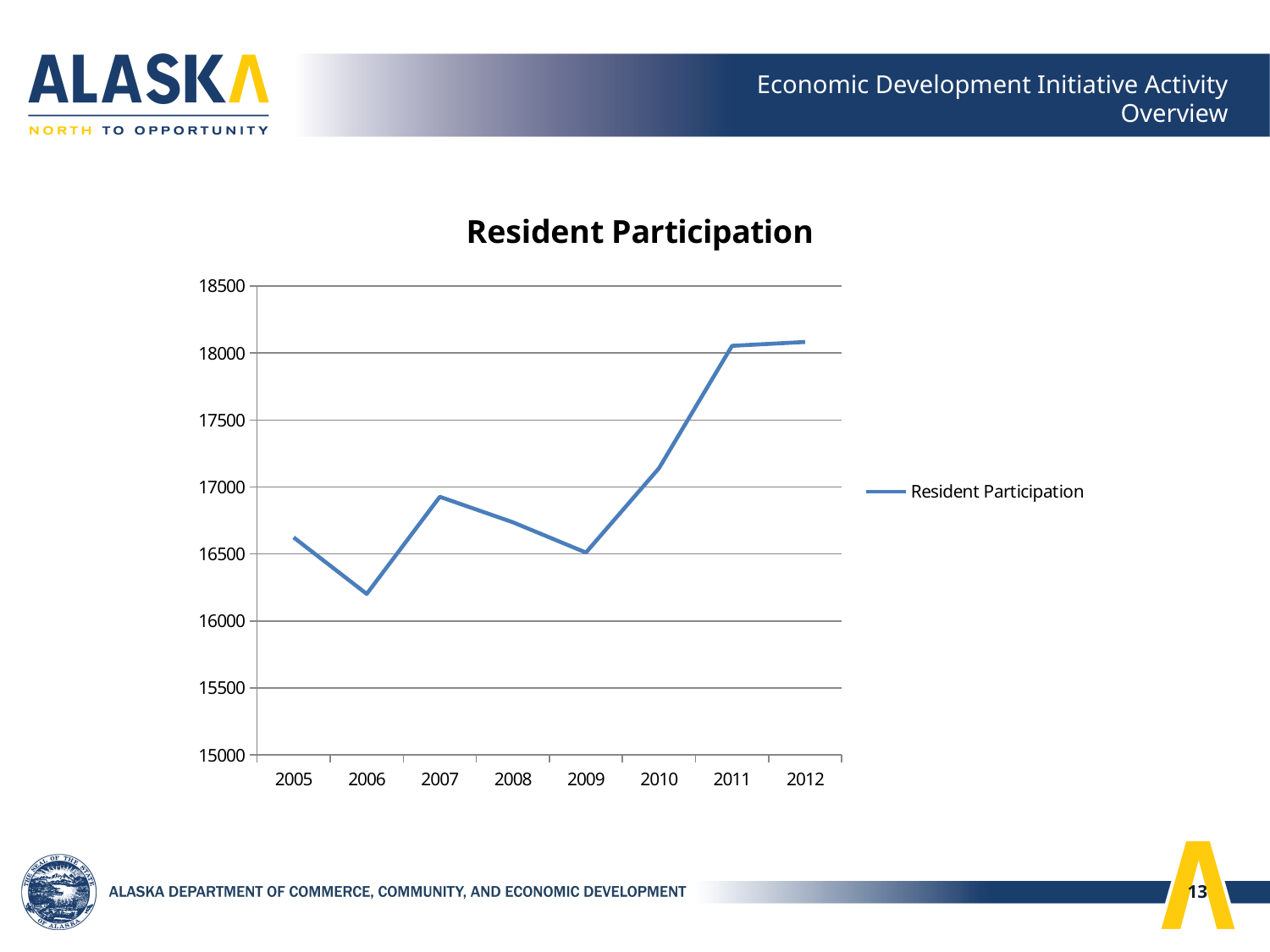
Overall, does Resident Participation rise or fall from 2005 to 2012? rise What type of chart is shown on the slide? line chart Which year has the larger Resident Participation value, 2009 or 2011? 2011 Is the Resident Participation value for 2006 greater or less than 16500? less Is the Resident Participation value for 2007 greater or less than 17000? less Is the Resident Participation value for 2011 greater or less than 18000? greater What is the title of the chart? Resident Participation Which year has the lowest Resident Participation value? 2006 How many series does the legend list? 1 How many years are plotted on the x axis? 8 Which year has the larger Resident Participation value, 2006 or 2007? 2007